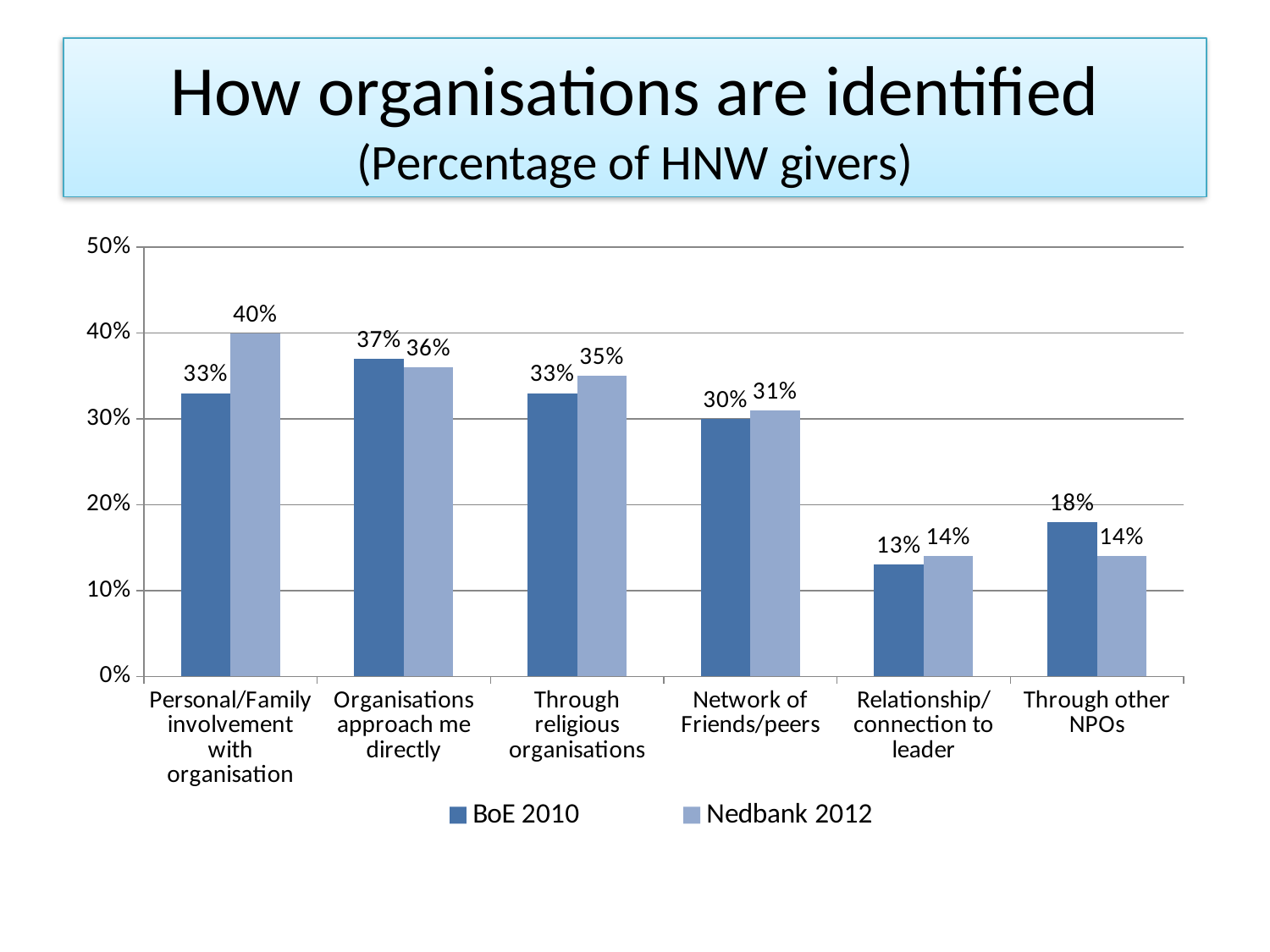
For Organisations approach me directly, which series has the larger value, BoE 2010 or Nedbank 2012? BoE 2010 What kind of chart is shown on the slide? Bar chart What is the title of the chart on the slide? How organisations are identified (Percentage of HNW givers) What is the BoE 2010 value for Relationship/connection to leader? 13% What is the Nedbank 2012 value for Personal/Family involvement with organisation? 40% Which category has the highest Nedbank 2012 value? Personal/Family involvement with organisation What is the difference between the Nedbank 2012 and BoE 2010 values for Personal/Family involvement with organisation? 7% What is the difference between the BoE 2010 and Nedbank 2012 values for Through other NPOs? 4% What is the BoE 2010 value for Organisations approach me directly? 37% How many series does the legend list? 2 How many categories are shown on the x axis? 6 Which category has the lowest BoE 2010 value? Relationship/connection to leader